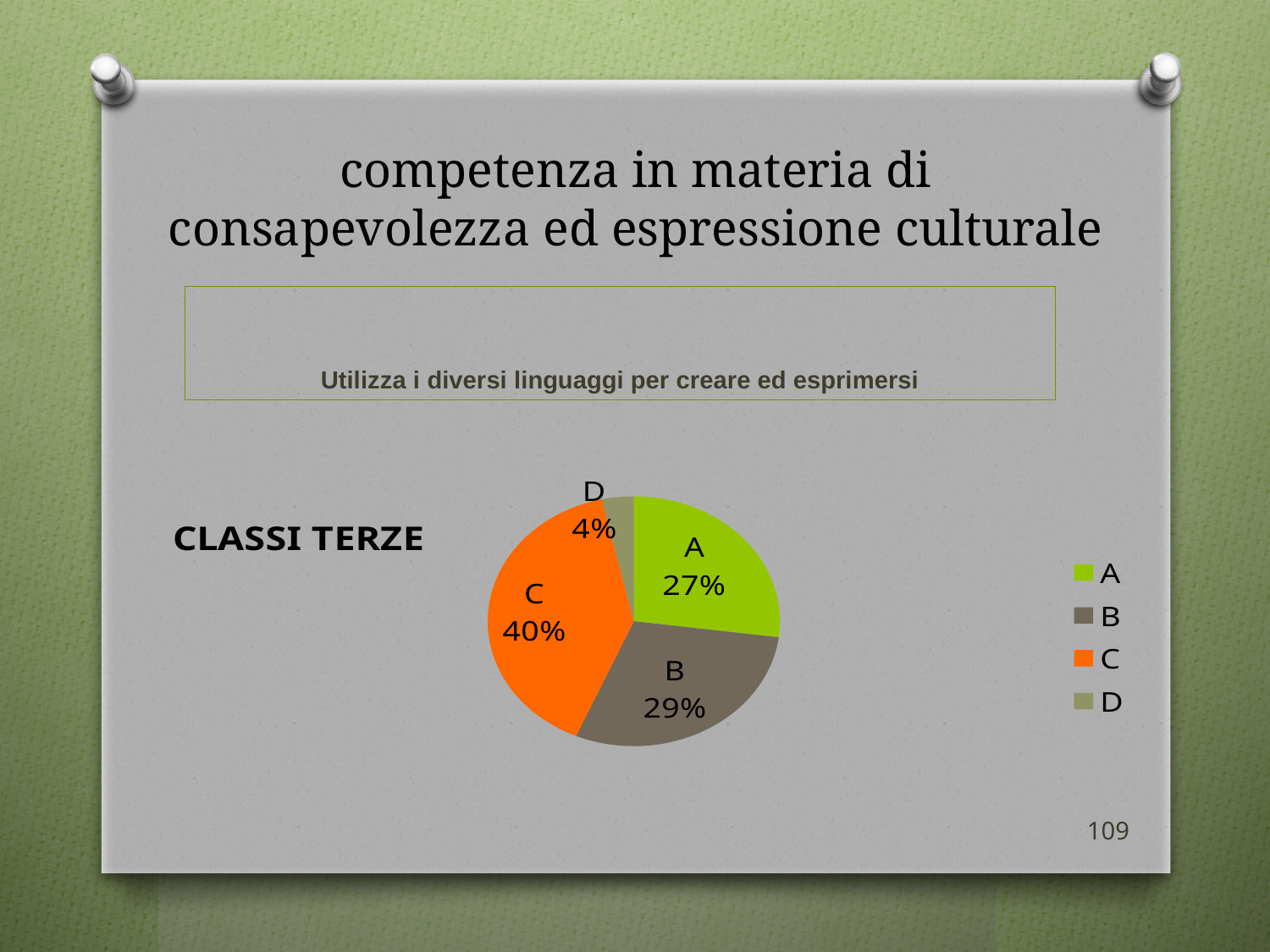
What percentage does slice B represent? 29% What percentage does slice A represent? 27% Which slice is the largest? C Which slice is the smallest? D What percentage does slice C represent? 40% What percentage does slice D represent? 4% What is the difference in percentage points between slice C and slice A? 13 What type of chart is shown on the slide? pie chart Which is larger, slice B or slice D? B How many entries does the legend list? 4 How many slices does the pie chart have? 4 What colour is slice C in the pie chart? orange